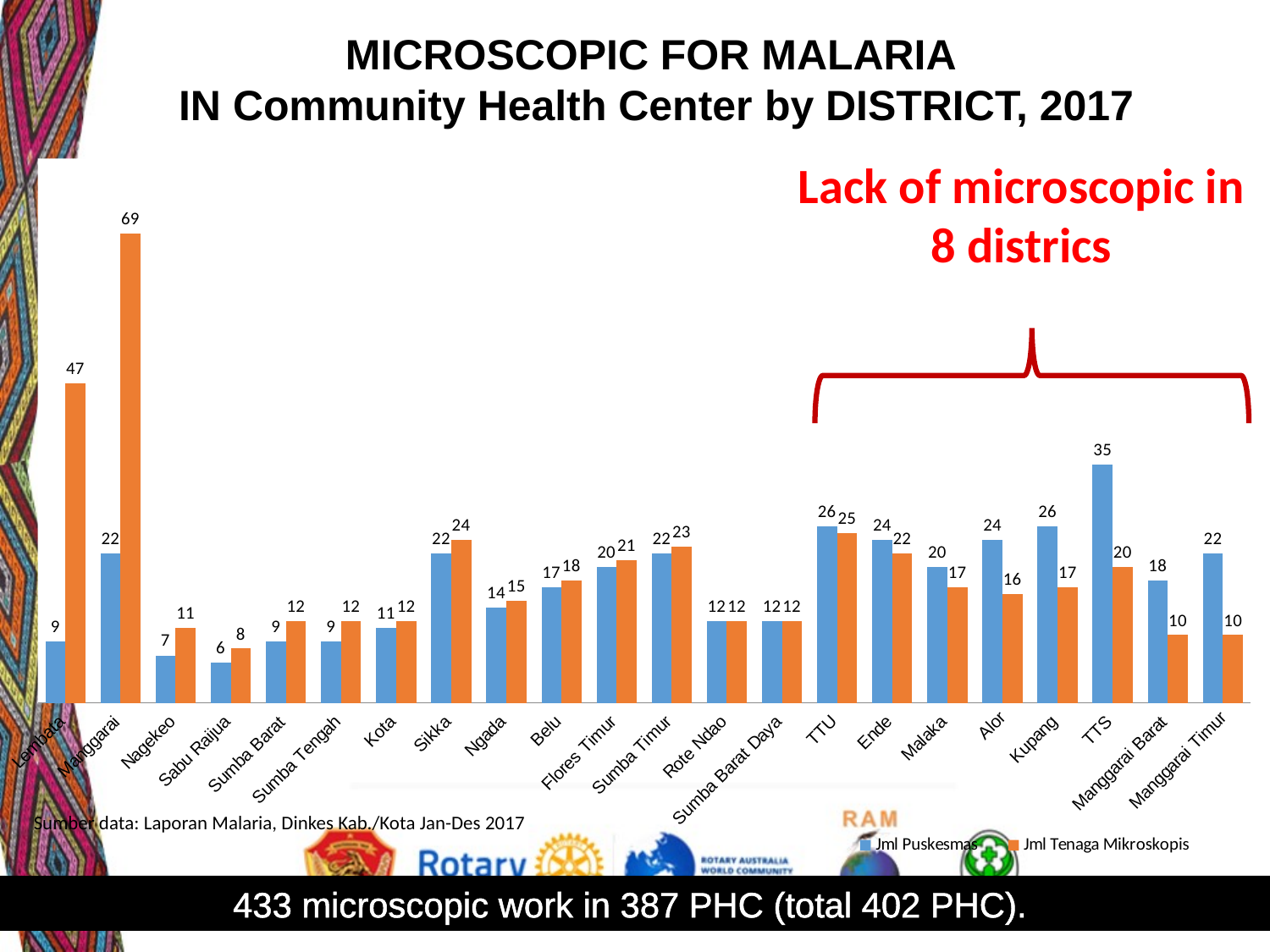
Which district has the lowest Jml Puskesmas value? Sabu Raijua What is the Jml Tenaga Mikroskopis value for Manggarai? 69 Which is larger for Kupang: Jml Puskesmas or Jml Tenaga Mikroskopis? Jml Puskesmas How many series does the legend list? 2 What is the Jml Tenaga Mikroskopis value for Alor? 16 Which colour represents Jml Tenaga Mikroskopis in the chart? Orange Which district has the highest Jml Tenaga Mikroskopis value? Manggarai How many districts are shown on the x axis of the chart? 22 What is the Jml Puskesmas value for TTS? 35 Which district has the highest Jml Puskesmas value? TTS What is the difference between the Jml Tenaga Mikroskopis and Jml Puskesmas values for Lembata? 38 What kind of chart is shown on the slide? Bar chart